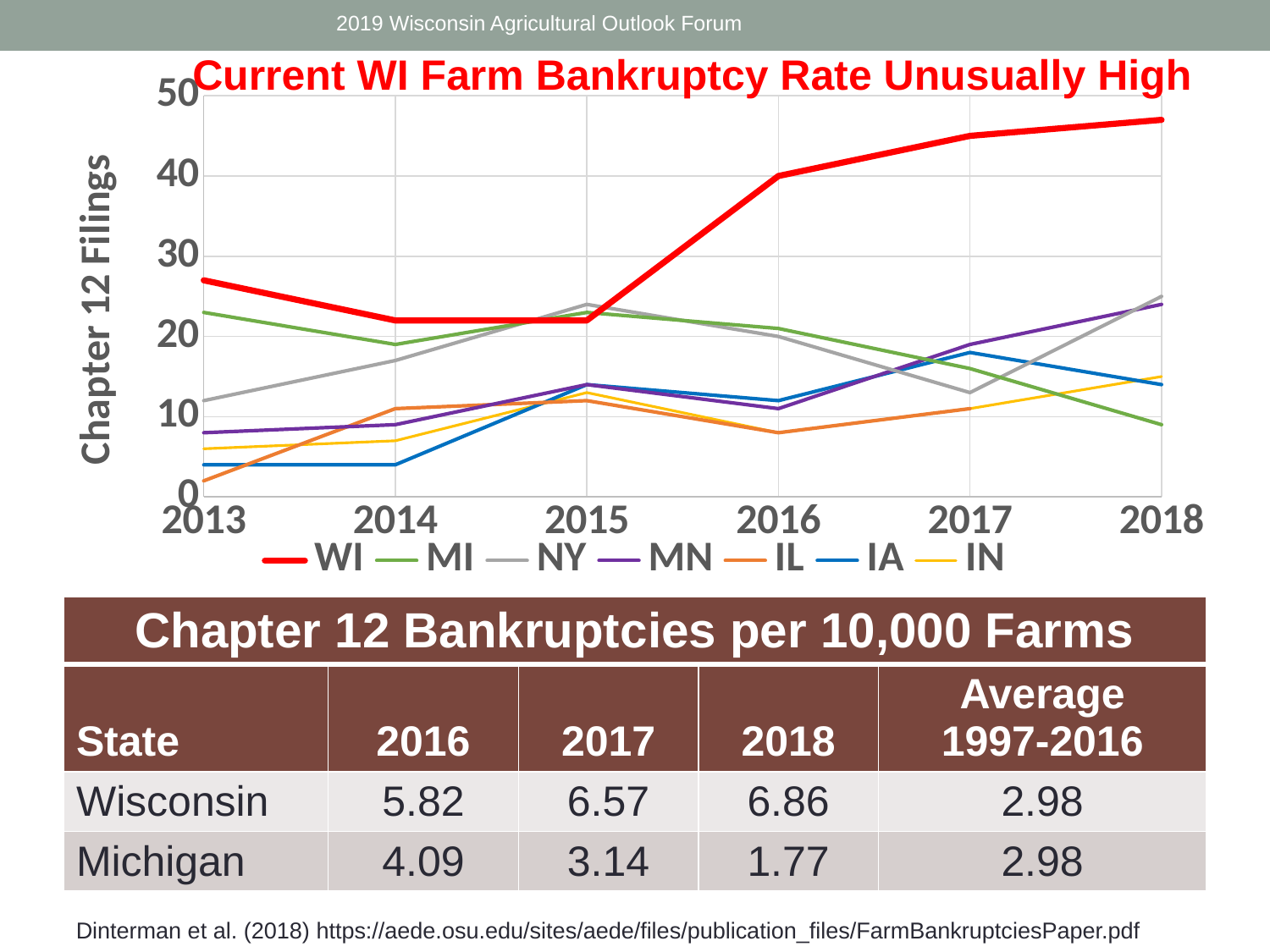
Which is larger in 2016, the value for WI or the value for MI? WI Is the value for WI in 2014 greater or less than 30? less Which state has the highest number of Chapter 12 filings in 2018? WI What is the label on the y axis of the chart? Chapter 12 Filings Does the WI line rise or fall between 2015 and 2018? rise Does the MI line rise or fall between 2016 and 2018? fall How many series does the chart legend list? 7 What kind of chart is shown on the slide? line chart How many years are shown along the x axis of the chart? 6 Is the value for MI in 2018 greater or less than 10? less Is the value for WI in 2018 greater or less than 40? greater Which state has the lowest number of Chapter 12 filings in 2018? MI